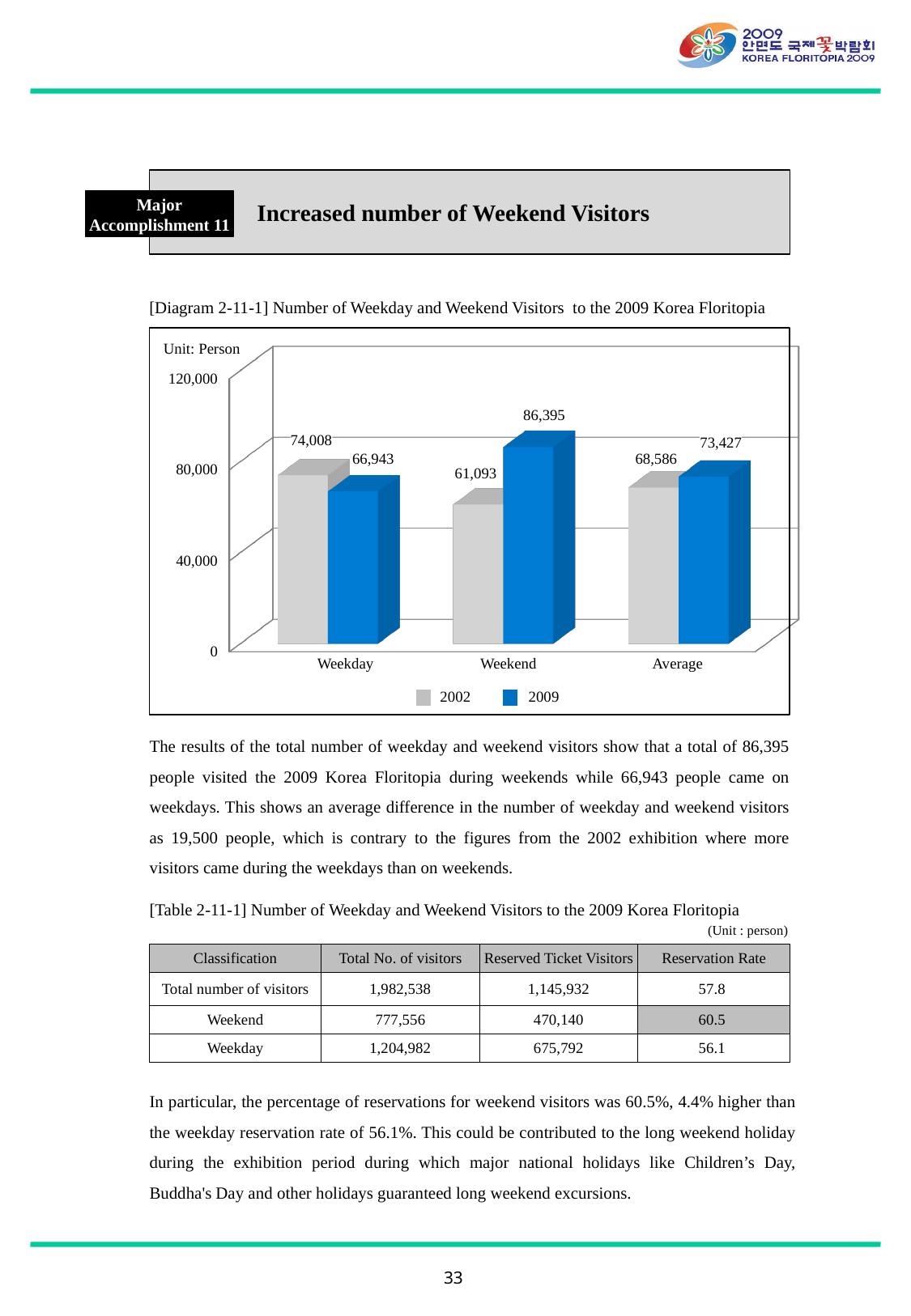
Which is larger, the 2002 weekday value or the 2009 weekday value? 2002 weekday value What is the number of weekday visitors in 2002? 74,008 Is the 2009 weekend value greater or less than 80,000? greater Which category has the highest value for the 2009 series? Weekend What unit is stated for the values in the chart? Person Which category has the lowest value for the 2002 series? Weekend What is the difference between the 2009 and 2002 weekend visitor numbers? 25,302 How many categories are shown on the x axis? 3 What is the average number of visitors in 2009? 73,427 What kind of chart is shown in Diagram 2-11-1? Bar chart What is the number of weekend visitors in 2009? 86,395 How many series does the legend list? 2